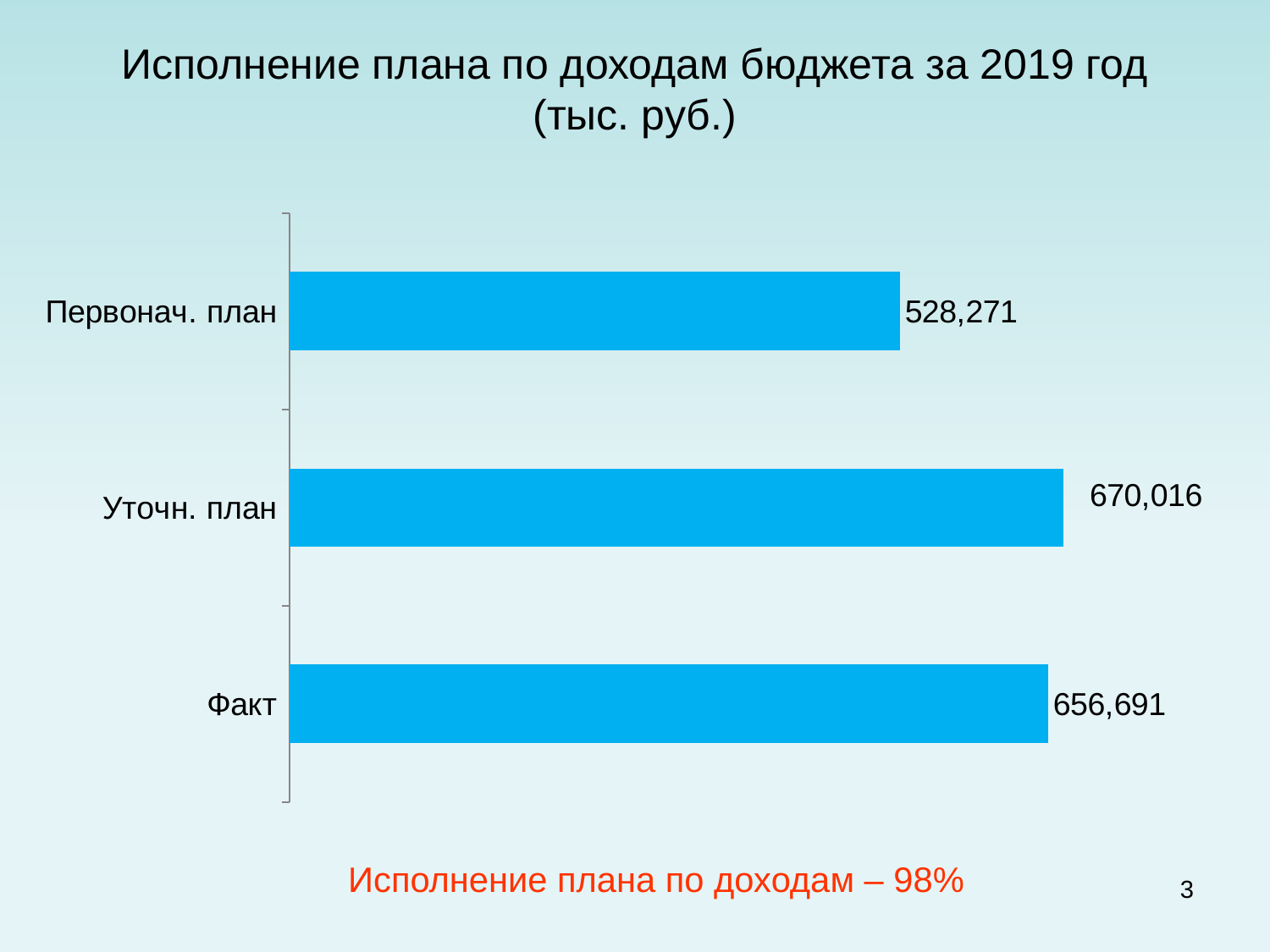
What is the value for Факт? 656,691 How many categories are shown in the chart? 3 What is the difference between Уточн. план and Факт? 13,325 What is the difference between Факт and Первонач. план? 128,420 What is the difference between Уточн. план and Первонач. план? 141,745 What is the value for Первонач. план? 528,271 What is the value for Уточн. план? 670,016 What is the title of the chart on the slide? Исполнение плана по доходам бюджета за 2019 год (тыс. руб.) Which category has the highest value? Уточн. план Which category has the lowest value? Первонач. план Which is larger, Факт or Первонач. план? Факт What kind of chart is shown on the slide? Bar chart